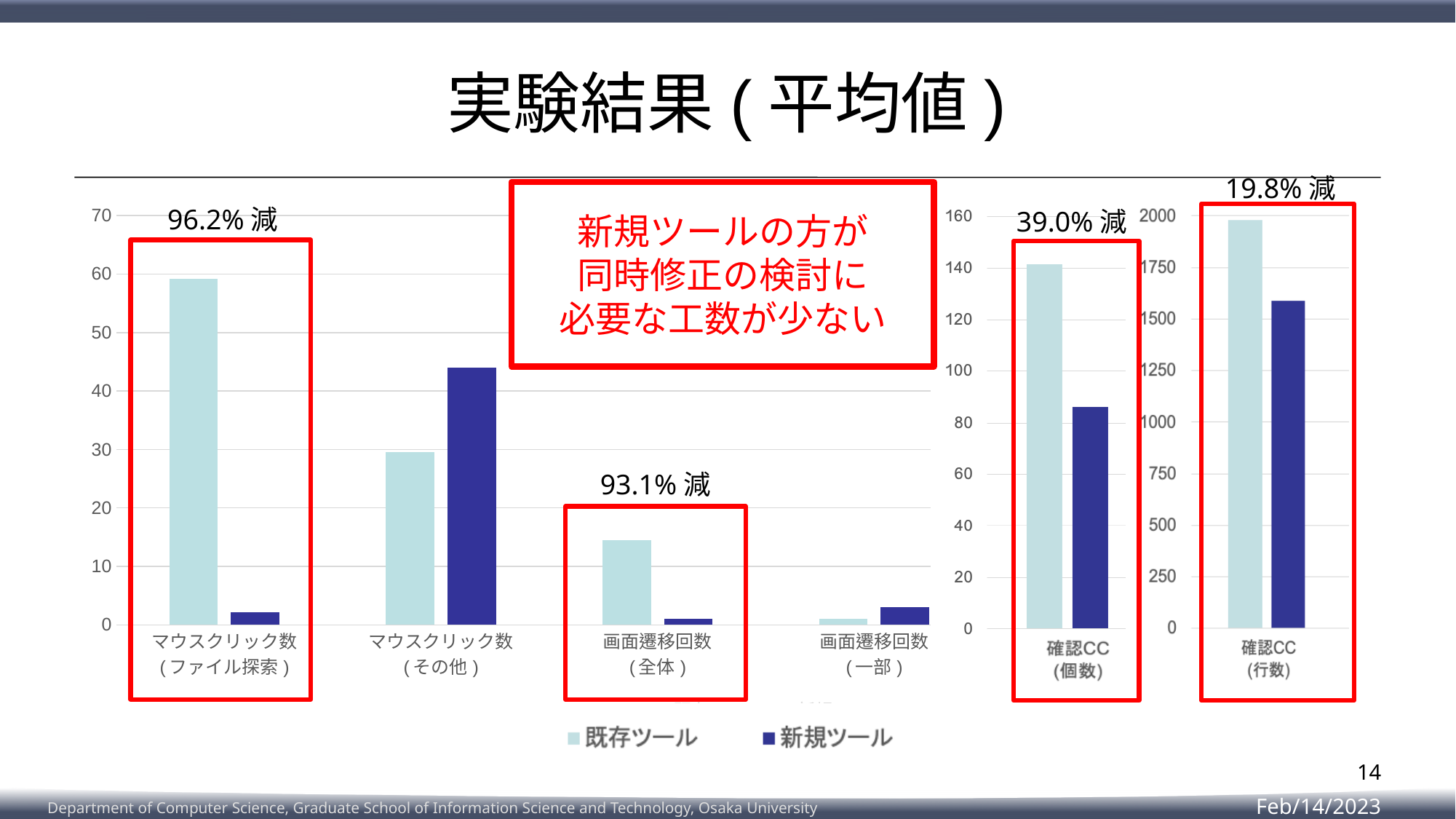
How many series does the legend list? 2 On the right chart (確認CC 行数), is the 新規ツール value greater or less than 1500? greater On the left chart (axis 0–70), how many categories are shown on the x axis? 4 On the right chart (確認CC 行数), is the 既存ツール value greater or less than 1750? greater On the middle chart (確認CC 個数), is the 新規ツール value greater or less than 100? less On the middle chart (確認CC 個数), which series has the larger value, 既存ツール or 新規ツール? 既存ツール On the left chart, for マウスクリック数(その他), which series has the larger value, 既存ツール or 新規ツール? 新規ツール What percentage reduction is annotated above 画面遷移回数(全体) on the left chart? 93.1% 減 What kind of chart is used on the left chart (マウスクリック数 / 画面遷移回数)? bar chart On the left chart, which category has the highest 既存ツール value? マウスクリック数(ファイル探索)